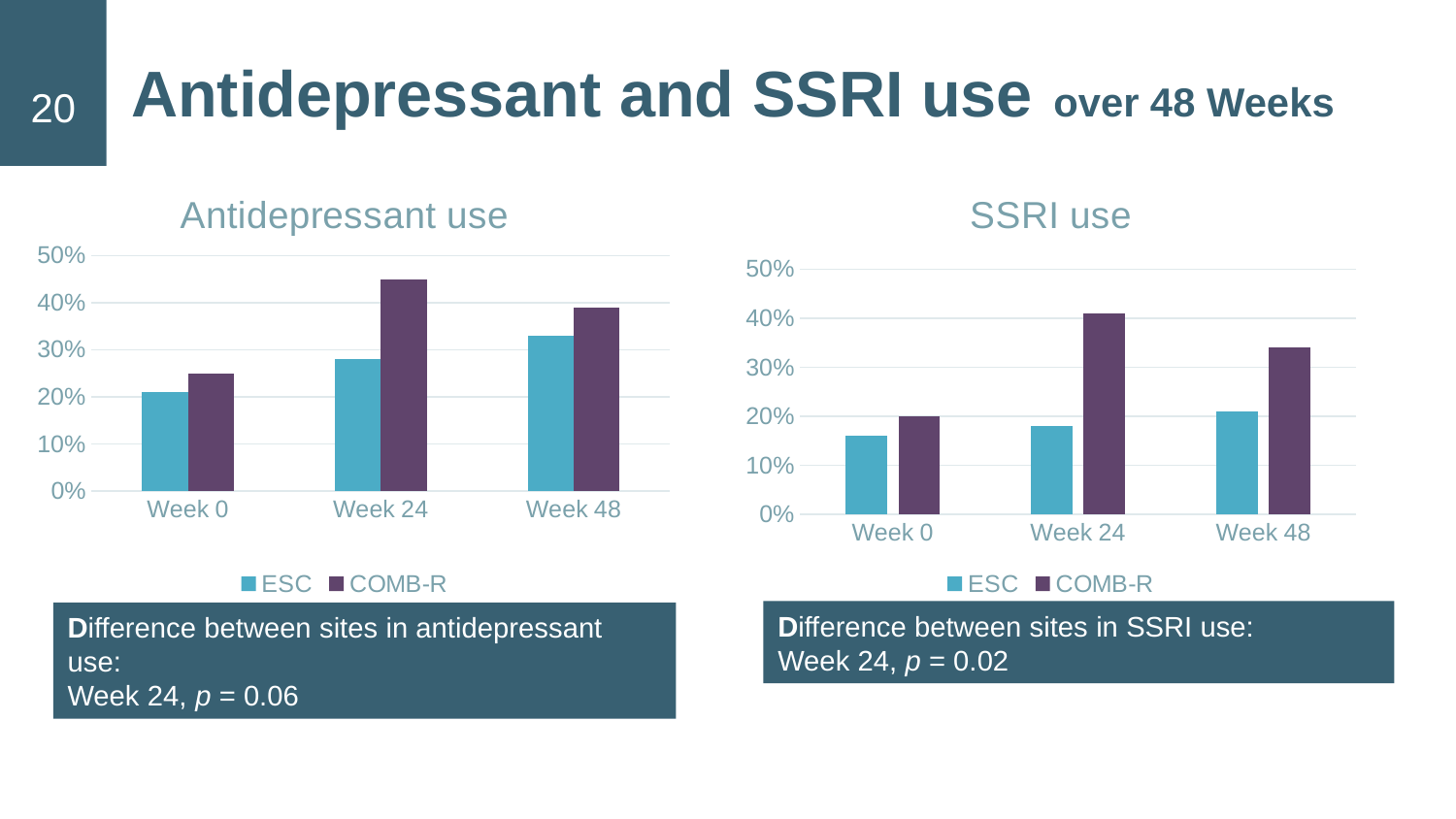
In the SSRI use chart, is the value for COMB-R at Week 24 greater or less than 30%? greater In the SSRI use chart, does the ESC value rise or fall from Week 0 to Week 48? rise What are the two series named in the legend of the Antidepressant use chart? ESC and COMB-R What kind of chart is the SSRI use chart? bar chart How many series does the legend of the Antidepressant use chart list? 2 How many week categories are shown on the x axis of the SSRI use chart? 3 In the Antidepressant use chart, at which week is the COMB-R value highest? Week 24 In the Antidepressant use chart, which series has the larger value at Week 24, ESC or COMB-R? COMB-R In the Antidepressant use chart, is the value for COMB-R at Week 24 greater or less than 40%? greater In the Antidepressant use chart, is the value for ESC at Week 0 greater or less than 30%? less In the SSRI use chart, at which week is the ESC value lowest? Week 0